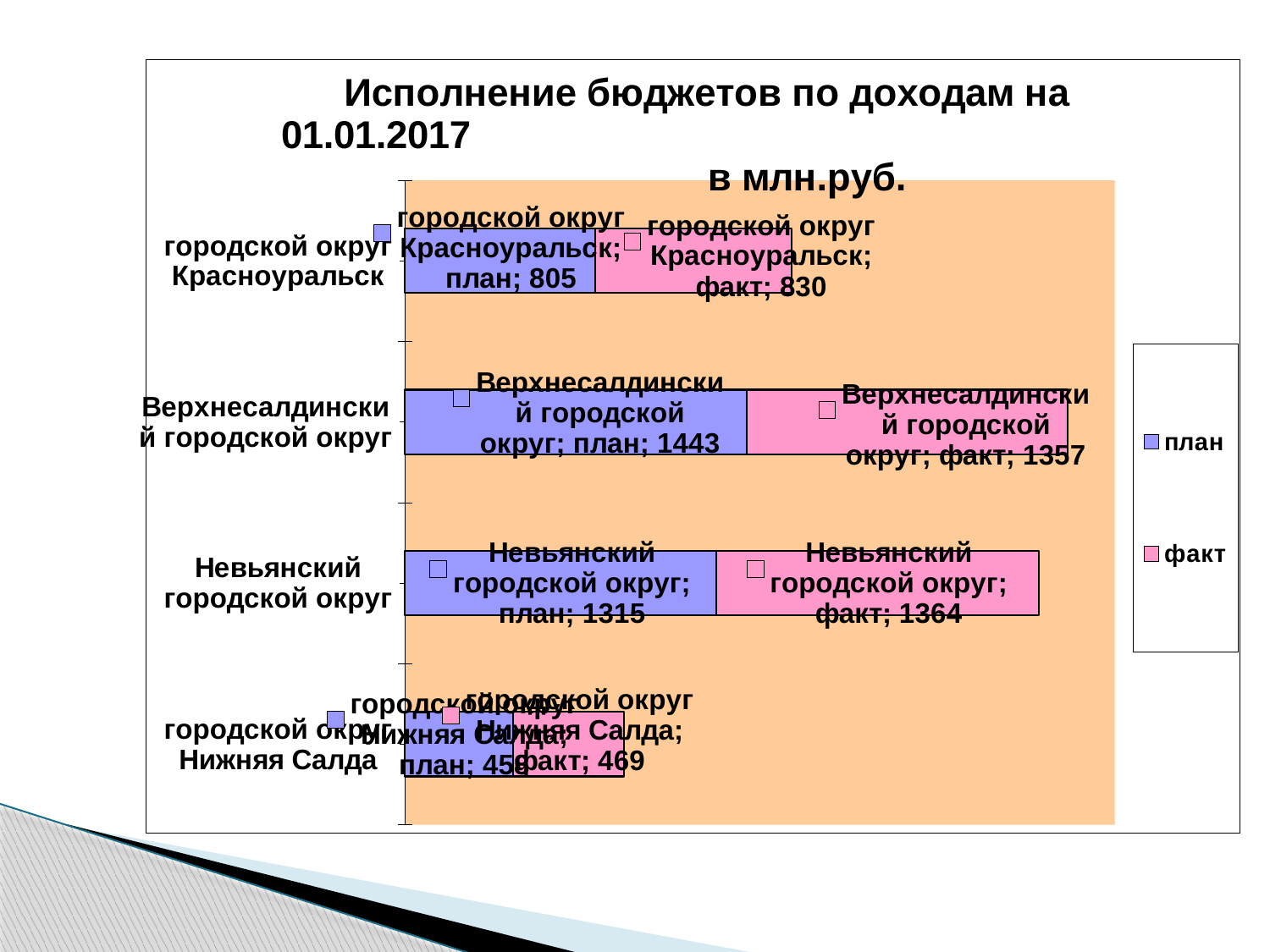
How many series does the legend list? 2 What is the total of the stacked bar (план plus факт) for городской округ Красноуральск? 1635 What kind of chart is shown on the slide? bar chart What is the план value for Верхнесалдинский городской округ? 1443 What is the факт value for Невьянский городской округ? 1364 For Невьянский городской округ, which is larger: план or факт? факт How many categories (городские округа) are shown on the chart? 4 Which category has the highest план value? Верхнесалдинский городской округ Which category has the lowest факт value? городской округ Нижняя Салда What is the факт value for городской округ Красноуральск? 830 What is the факт value for городской округ Нижняя Салда? 469 What is the difference between the план and факт values for Верхнесалдинский городской округ? 86